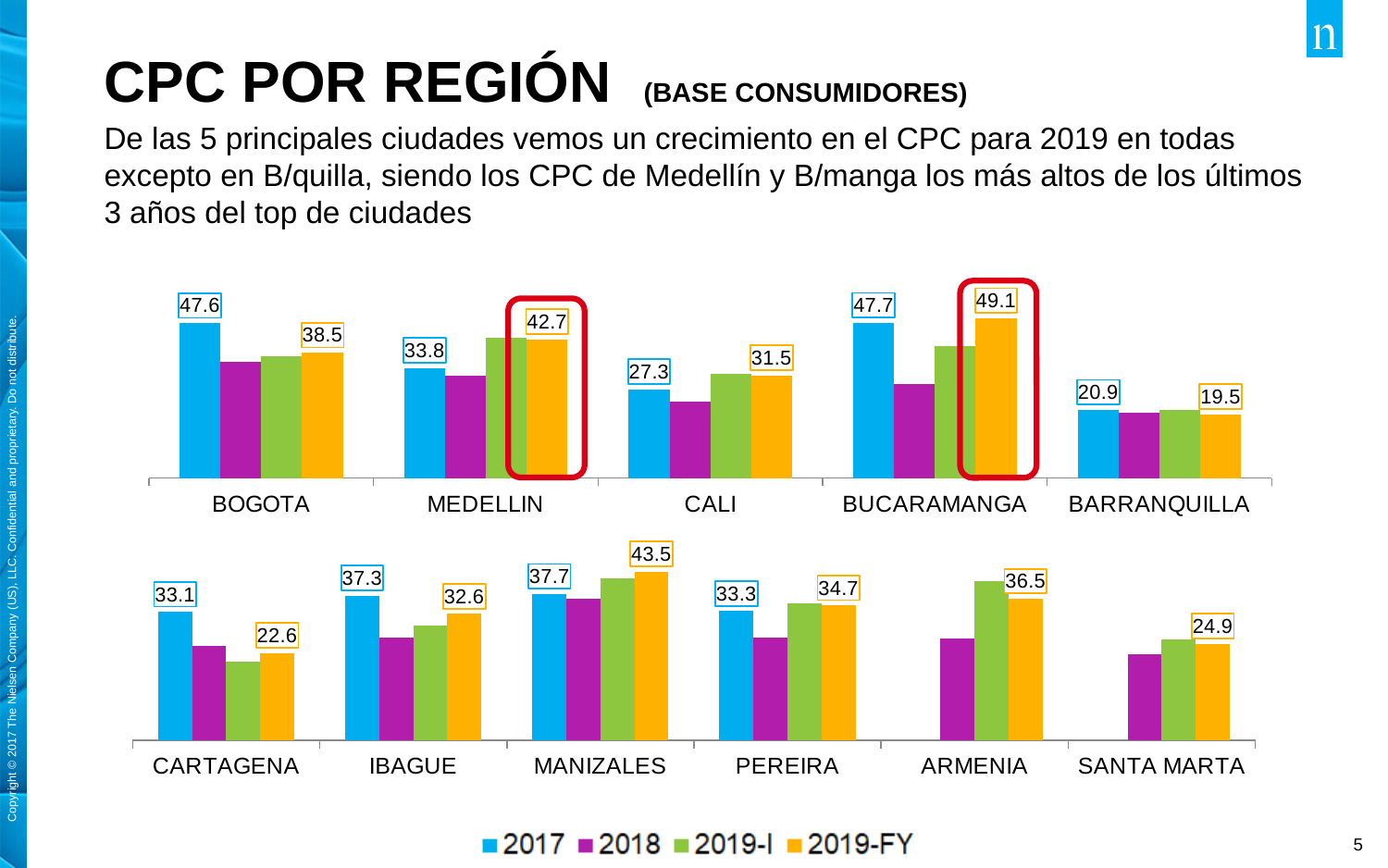
In the bottom chart, what is the difference between the 2017 and 2019-FY values for CARTAGENA? 10.5 In the bottom chart, what is the 2017 value for IBAGUE? 37.3 In the top chart, what is the 2017 value for BOGOTA? 47.6 In the top chart, which is larger for BARRANQUILLA: the 2017 value or the 2019-FY value? 2017 In the top chart, what is the difference between the 2019-FY and 2017 values for MEDELLIN? 8.9 How many series does the legend list? 4 In the bottom chart, which city has the lowest 2019-FY value? CARTAGENA In the top chart, what is the 2019-FY value for MEDELLIN? 42.7 In the top chart, which city has the highest 2019-FY value? BUCARAMANGA In the top chart, which city has the lowest 2017 value? BARRANQUILLA How many cities are shown in the bottom chart? 6 In the bottom chart, what is the 2019-FY value for MANIZALES? 43.5